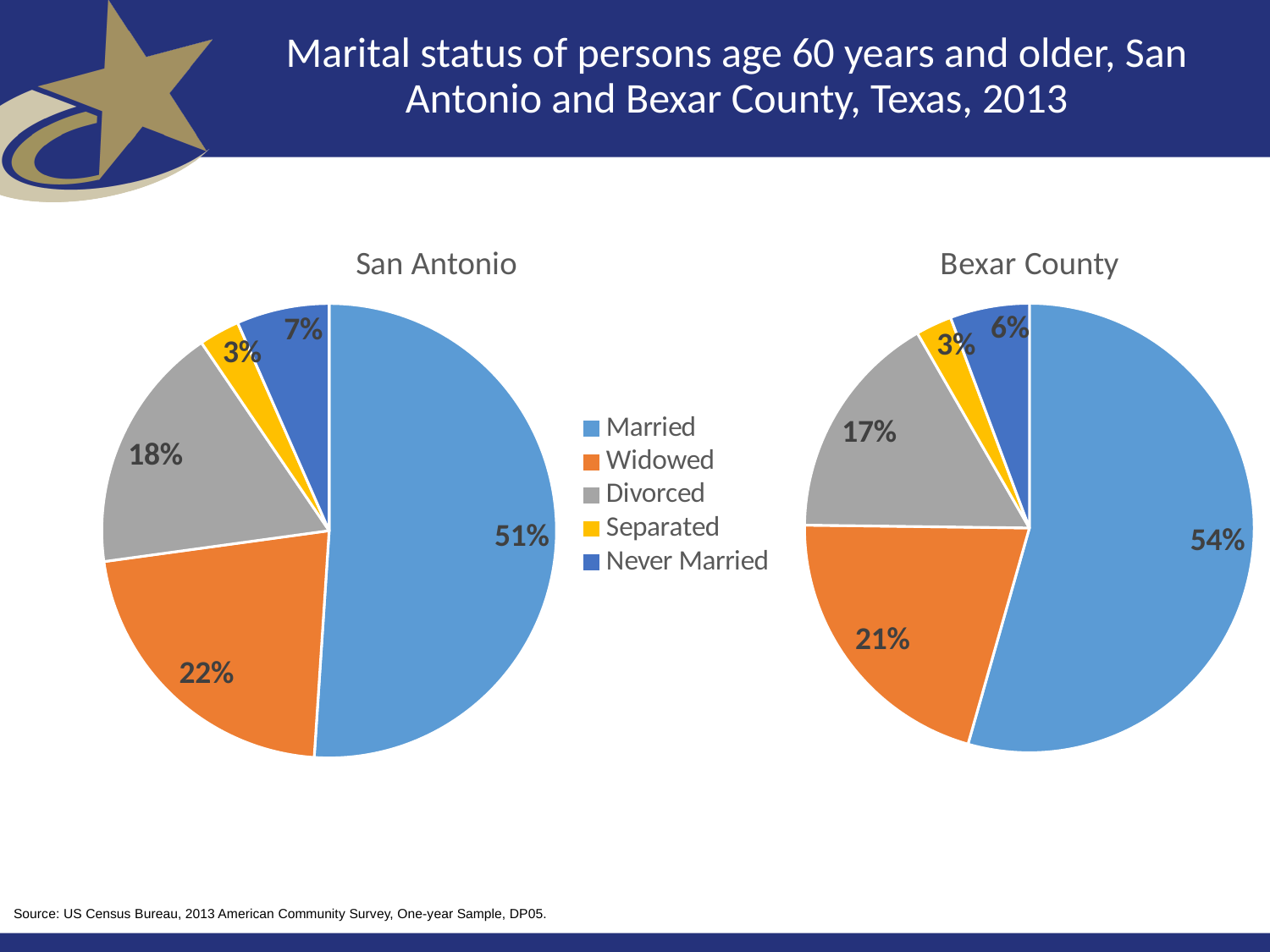
In the San Antonio pie chart, what is the difference between the Widowed and Divorced shares? 4 percentage points What type of chart is used for San Antonio and Bexar County? Pie chart Is the Widowed share larger in the San Antonio pie chart or the Bexar County pie chart? San Antonio In the San Antonio pie chart, what is the share for Divorced? 18% In the Bexar County pie chart, what percentage of persons age 60 and older are Widowed? 21% Which colour represents Separated in the legend? Yellow How many marital status categories does the legend list? 5 In the San Antonio pie chart, what percentage of persons age 60 and older are Married? 51% In the Bexar County pie chart, what is the share for Never Married? 6% In the San Antonio pie chart, which marital status has the largest slice? Married What is the difference between the Married share in Bexar County and the Married share in San Antonio? 3 percentage points In the Bexar County pie chart, which marital status has the smallest slice? Separated